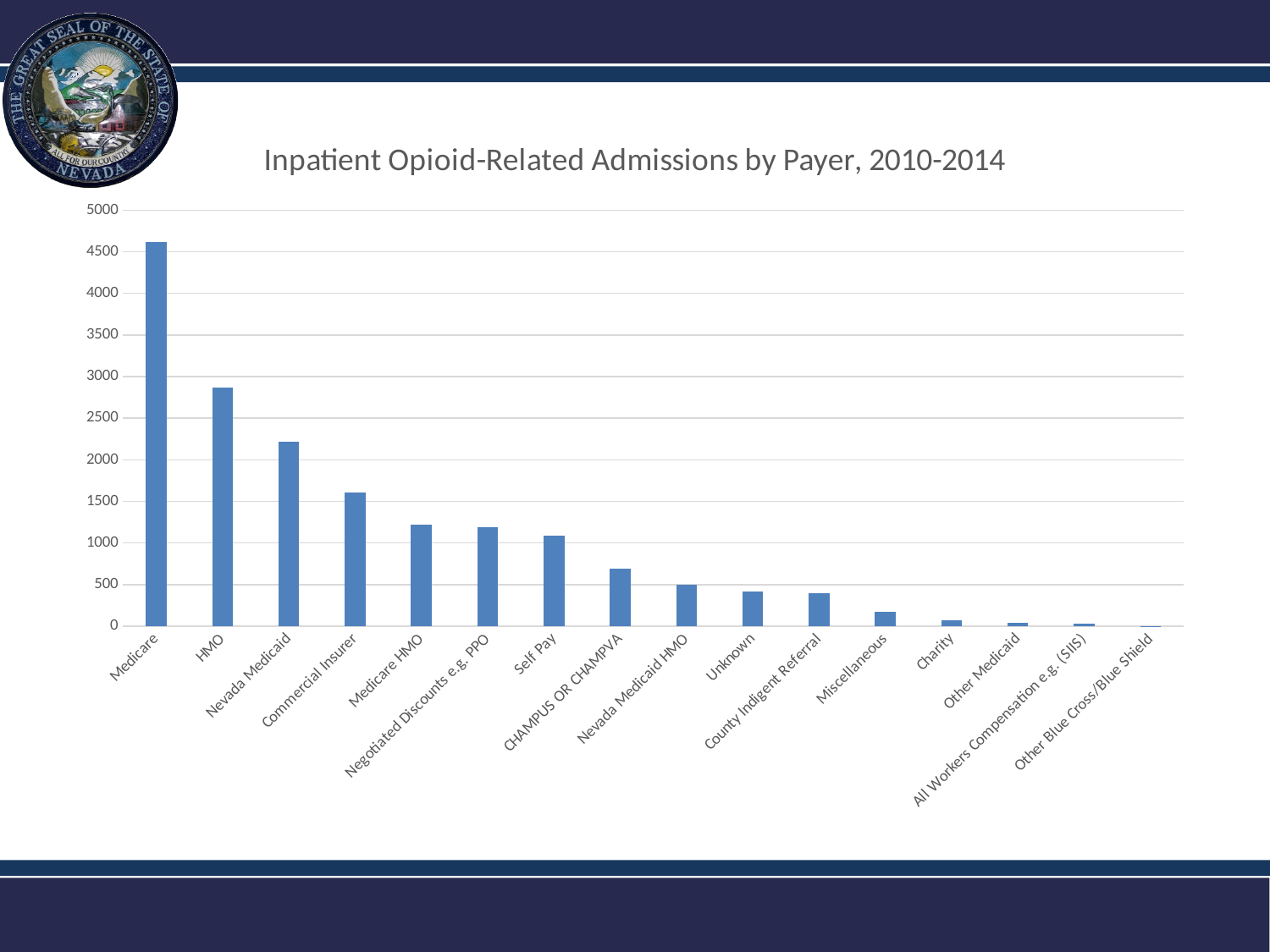
Which payer has the highest number of inpatient opioid-related admissions? Medicare Do the values generally rise or fall moving from left to right along the x axis? fall Is the value for Self Pay greater or less than 1000? greater Which payer has the lowest number of inpatient opioid-related admissions? Other Blue Cross/Blue Shield How many payer categories are shown on the x axis? 16 Is the value for HMO greater or less than 3000? less Is the value for Nevada Medicaid greater or less than 2000? greater What type of chart is shown on the slide? bar chart Which is larger, the value for Commercial Insurer or the value for Self Pay? Commercial Insurer What is the title of the chart? Inpatient Opioid-Related Admissions by Payer, 2010-2014